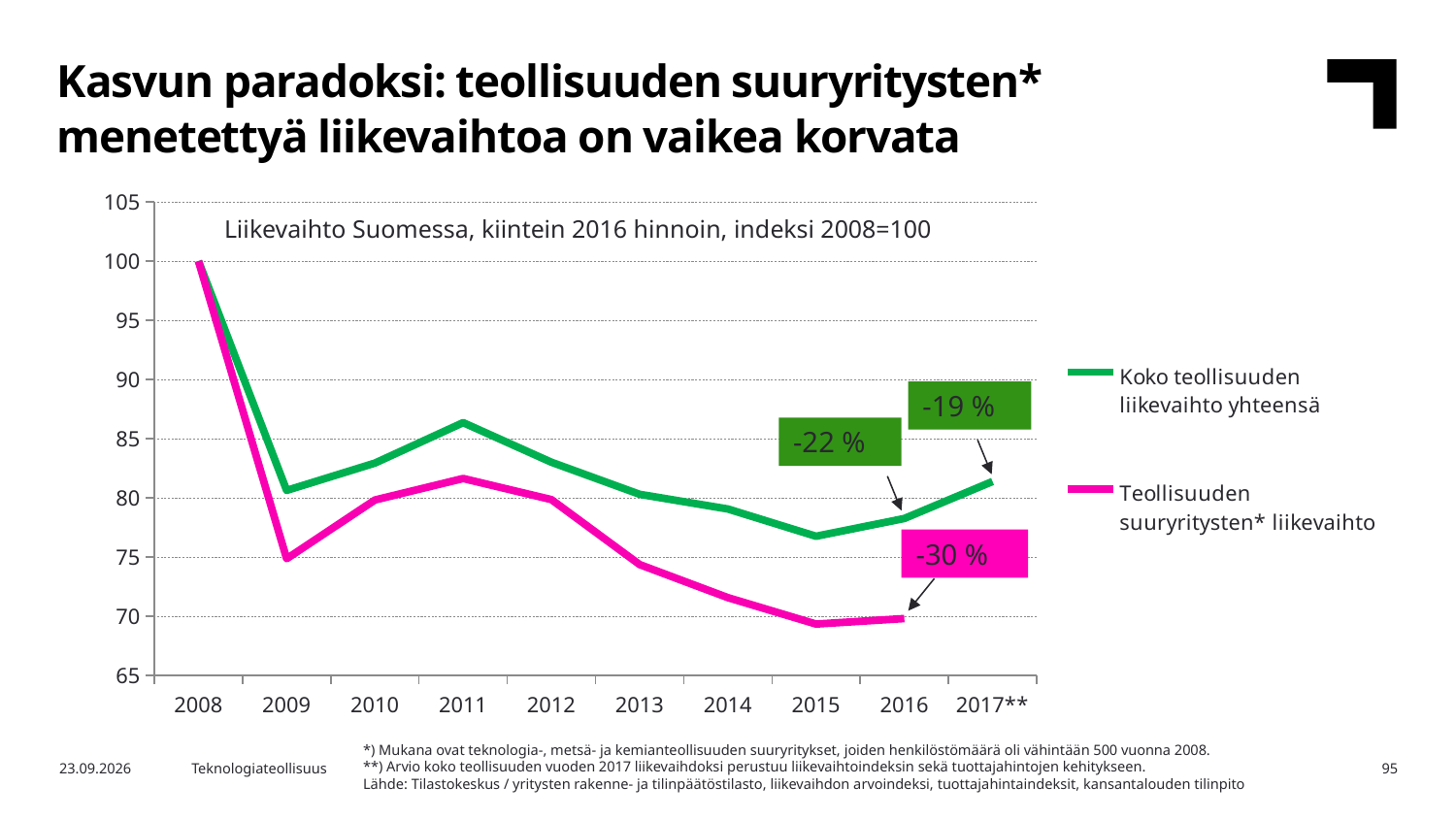
What is the index value of Koko teollisuuden liikevaihto yhteensä in 2008? 100 Is the value for Koko teollisuuden liikevaihto yhteensä in 2015 greater or less than 80? less In which year does Koko teollisuuden liikevaihto yhteensä reach its lowest value? 2015 Is the value for Teollisuuden suuryritysten* liikevaihto in 2015 greater or less than 75? less What kind of chart is shown on the slide? line chart How many series does the legend list? 2 Is the value for Koko teollisuuden liikevaihto yhteensä in 2011 greater or less than 85? greater What percentage change is annotated on the Koko teollisuuden liikevaihto yhteensä line at 2017**? -19 % How many years are shown on the x axis? 10 Does the Koko teollisuuden liikevaihto yhteensä line rise or fall from 2015 to 2017**? rise What percentage change is annotated on the Teollisuuden suuryritysten* liikevaihto line? -30 % In 2015, which series has the higher value: Koko teollisuuden liikevaihto yhteensä or Teollisuuden suuryritysten* liikevaihto? Koko teollisuuden liikevaihto yhteensä